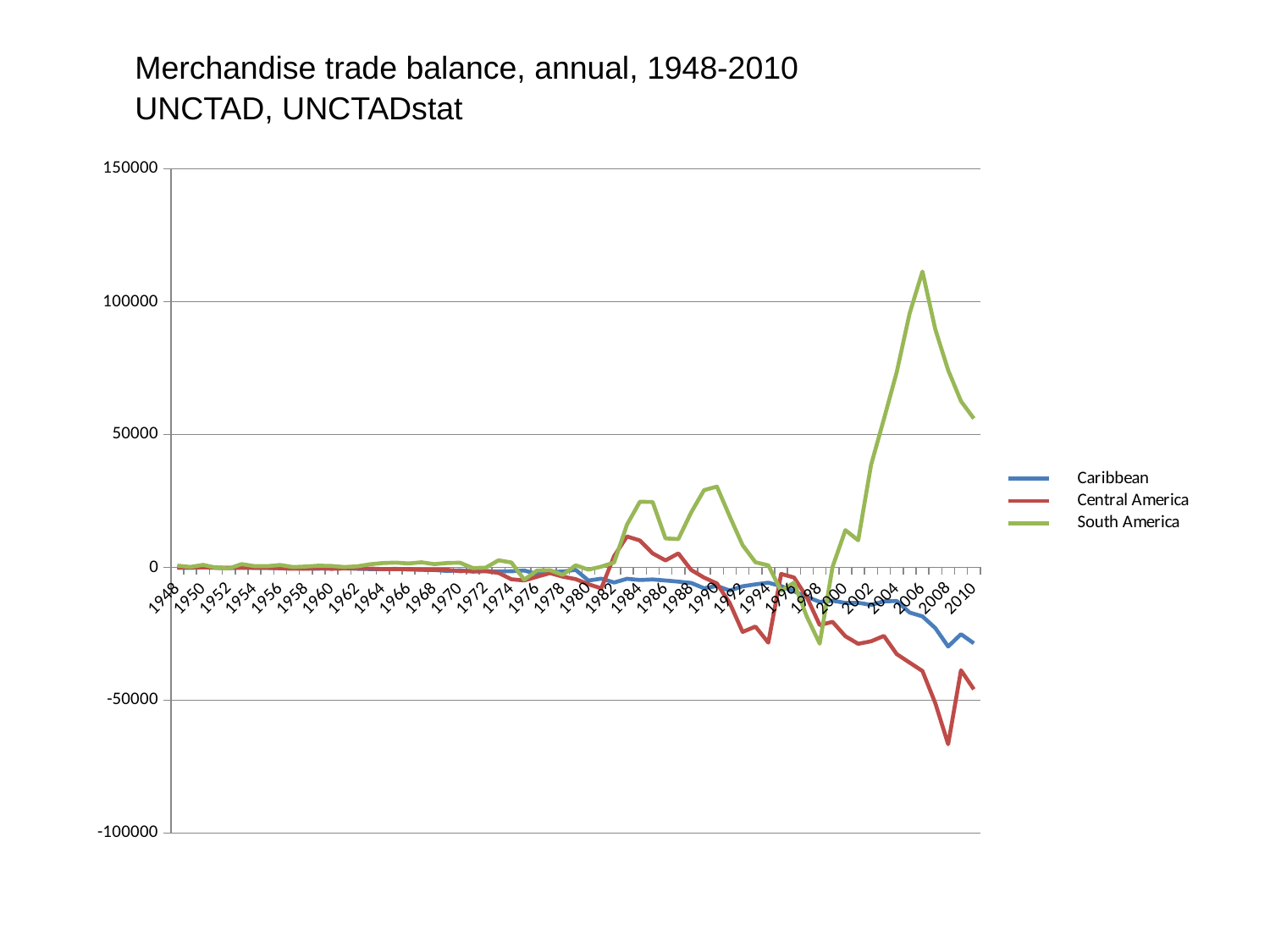
Does the South America line rise or fall from 2006 to 2010? fall What is the title of the chart? Merchandise trade balance, annual, 1948-2010 UNCTAD, UNCTADstat Is the value for Central America in 2008 greater or less than -50000? less In 2008, which is larger: the value for Caribbean or the value for Central America? Caribbean How many series does the legend list? 3 In 2010, which is larger: the value for South America or the value for Central America? South America Which series reaches the lowest value on the chart? Central America Is the value for Caribbean in 2010 greater or less than -50000? greater Is the value for South America in 2006 greater or less than 100000? greater Which series reaches the highest value on the chart? South America What kind of chart is shown on the slide? line chart